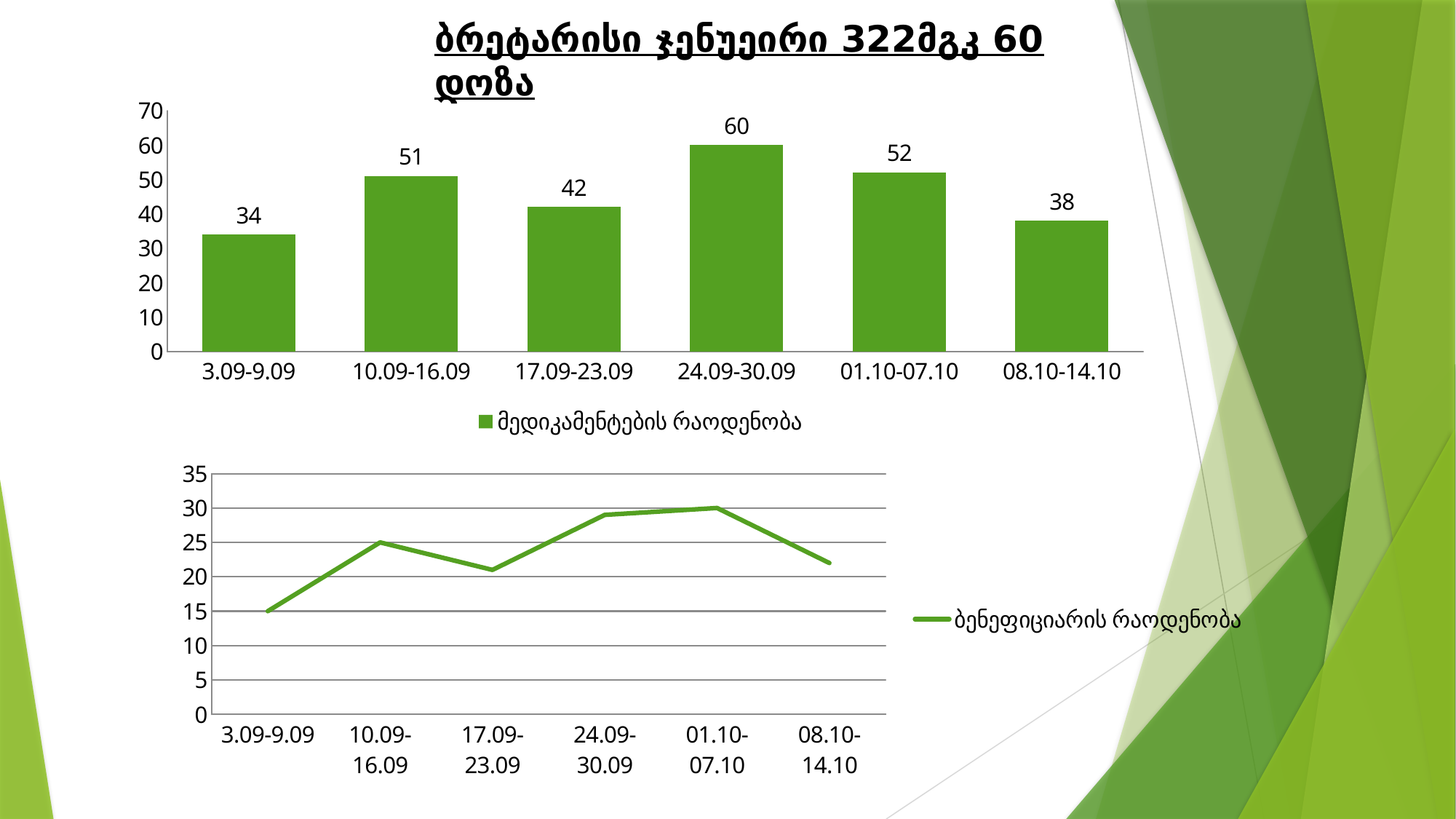
In the top bar chart, which is larger: the value for 01.10-07.10 or the value for 08.10-14.10? 01.10-07.10 In the bottom line chart, does the line rise or fall between 01.10-07.10 and 08.10-14.10? fall How many bars are in the top bar chart? 6 In the top bar chart, what is the difference between the values for 10.09-16.09 and 17.09-23.09? 9 In the top bar chart, what is the value for 24.09-30.09? 60 In the top bar chart, what is the value for 3.09-9.09? 34 In the top bar chart, which period has the highest value? 24.09-30.09 In the bottom line chart, is the value for 3.09-9.09 greater or less than 20? less In the top bar chart, which period has the lowest value? 3.09-9.09 What kind of chart is the top chart on the slide? bar chart What kind of chart is the bottom chart on the slide? line chart In the bottom line chart, is the value for 24.09-30.09 greater or less than 25? greater